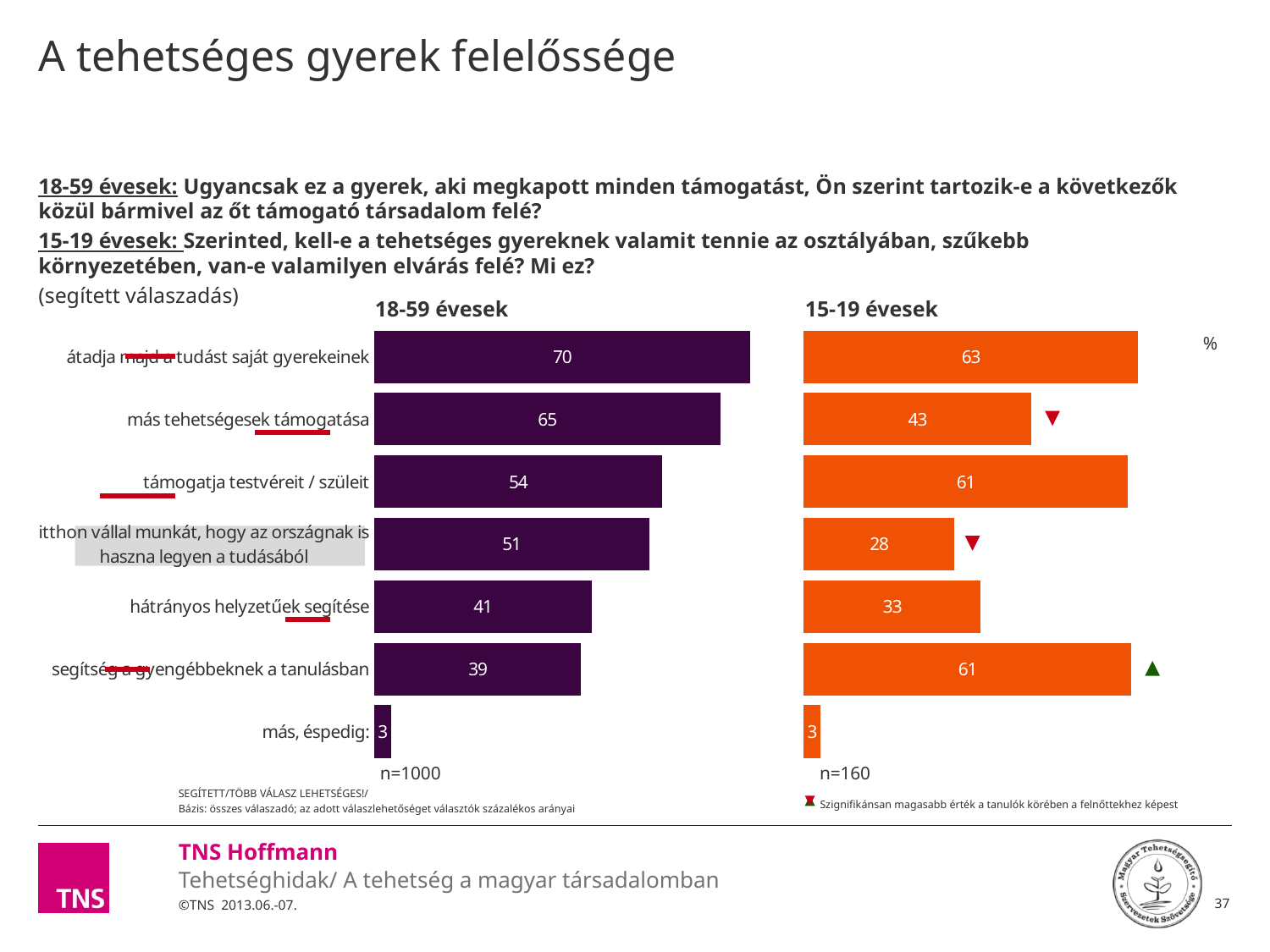
What kind of chart is the "15-19 évesek" chart? bar chart How many categories are shown in the "18-59 évesek" chart? 7 In the "18-59 évesek" chart, which is larger: "támogatja testvéreit / szüleit" or "hátrányos helyzetűek segítése"? támogatja testvéreit / szüleit What is the difference between the "18-59 évesek" and "15-19 évesek" values for "segítség a gyengébbeknek a tanulásban"? 22 In the "18-59 évesek" chart, what is the difference between "más tehetségesek támogatása" and "hátrányos helyzetűek segítése"? 24 In the "18-59 évesek" chart, which category has the highest value? átadja majd a tudást saját gyerekeinek In the "15-19 évesek" chart, what is the value for "más tehetségesek támogatása"? 43 In the "18-59 évesek" chart, what is the value for "átadja majd a tudást saját gyerekeinek"? 70 In the "15-19 évesek" chart, which category has the lowest value? más, éspedig What is the sample size (n) shown under the "15-19 évesek" chart? n=160 For "támogatja testvéreit / szüleit", which chart shows the larger value, "18-59 évesek" or "15-19 évesek"? 15-19 évesek In the "15-19 évesek" chart, what is the value for "itthon vállal munkát, hogy az országnak is haszna legyen a tudásából"? 28